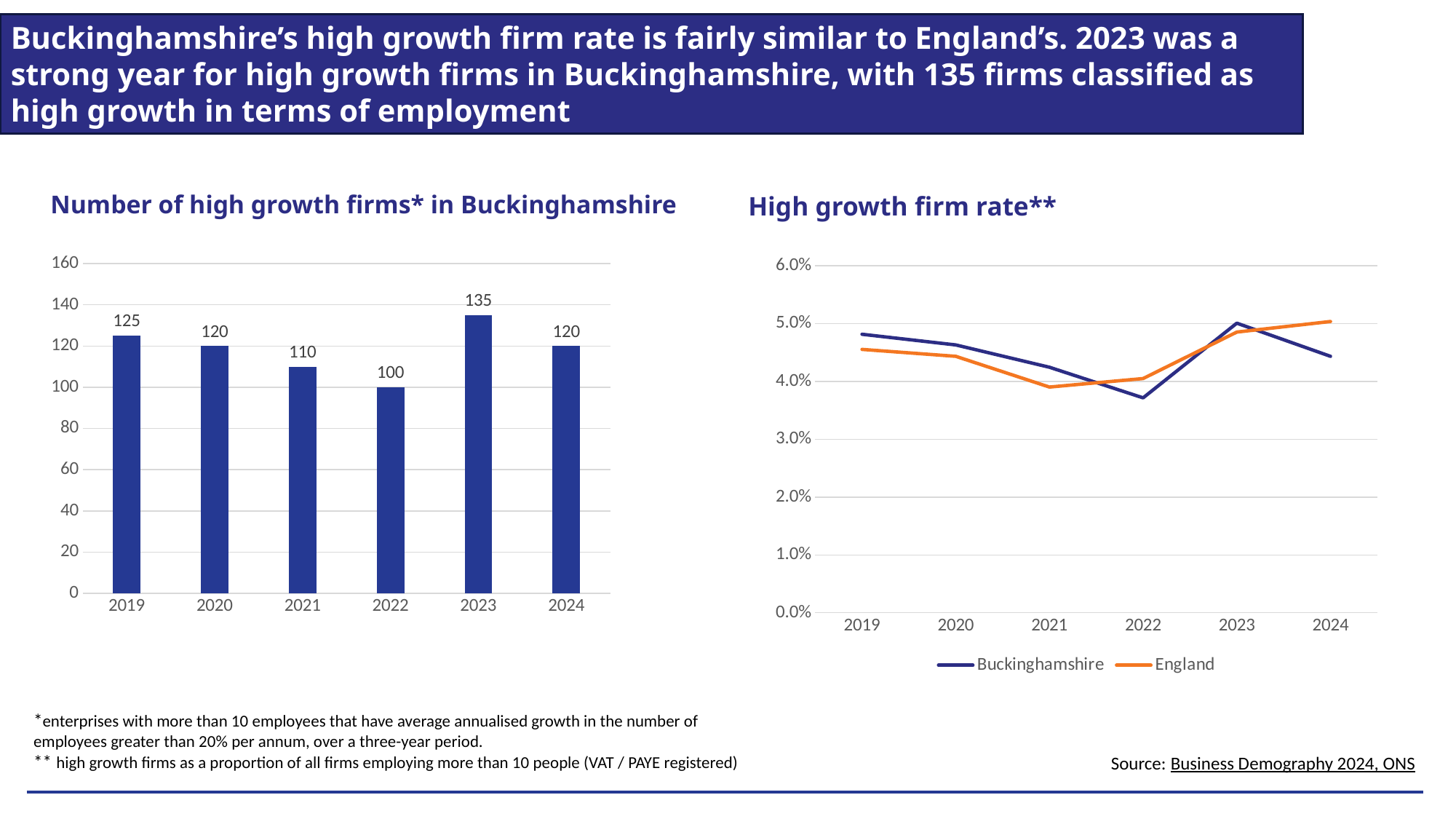
In the 'Number of high growth firms* in Buckinghamshire' chart, which is larger, the value for 2019 or the value for 2021? 2019 In the 'Number of high growth firms* in Buckinghamshire' chart, what is the value for 2022? 100 In the 'High growth firm rate**' chart, which series is drawn in orange? England In the 'Number of high growth firms* in Buckinghamshire' chart, what is the value for 2023? 135 In the 'Number of high growth firms* in Buckinghamshire' chart, how many years are shown? 6 In the 'Number of high growth firms* in Buckinghamshire' chart, which year has the highest value? 2023 In the 'Number of high growth firms* in Buckinghamshire' chart, what is the difference between the 2023 and 2022 values? 35 What kind of chart is the 'Number of high growth firms* in Buckinghamshire' chart? Bar chart In the 'High growth firm rate**' chart, is the England value for 2024 greater or less than 4.0%? greater In the 'Number of high growth firms* in Buckinghamshire' chart, which year has the lowest value? 2022 In the 'High growth firm rate**' chart, how many series does the legend list? 2 In the 'High growth firm rate**' chart, is the Buckinghamshire value for 2022 greater or less than 4.0%? less